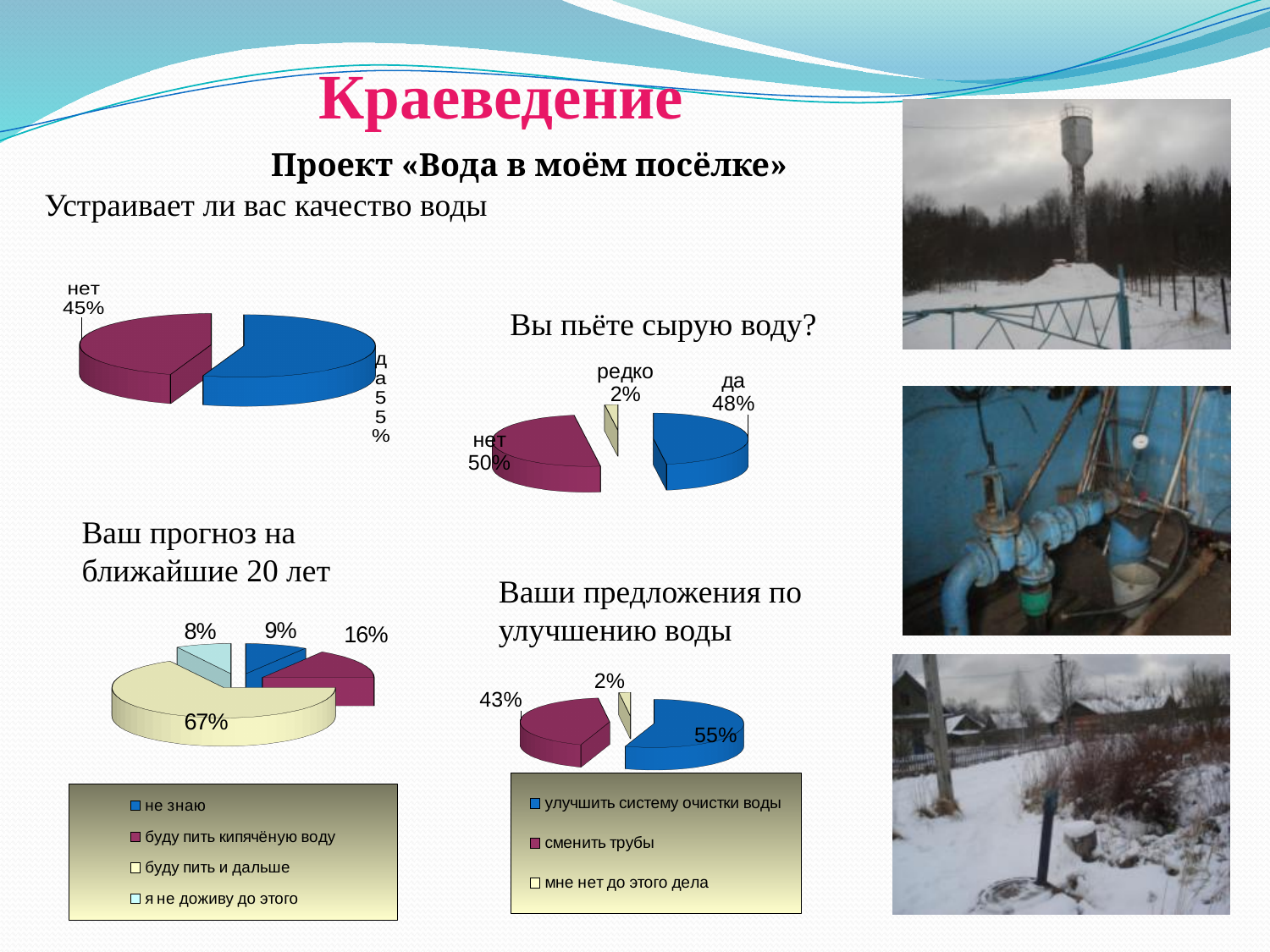
In the chart 'Вы пьёте сырую воду?', what is the value for 'редко'? 2% In the chart 'Вы пьёте сырую воду?', what is the difference between the 'нет' and 'да' shares? 2% In the chart 'Устраивает ли вас качество воды', what share of respondents answered 'нет'? 45% In the chart 'Вы пьёте сырую воду?', how many slices does the pie have? 3 In the chart 'Вы пьёте сырую воду?', which answer has the largest share? нет In the chart 'Ваш прогноз на ближайшие 20 лет', how many entries does the legend list? 4 In the chart 'Устраивает ли вас качество воды', what share of respondents answered 'да'? 55% In the chart 'Ваши предложения по улучшению воды', which proposal has the smallest share? мне нет до этого дела In the chart 'Ваш прогноз на ближайшие 20 лет', what is the share for 'буду пить кипячёную воду'? 16% What type of chart is used for 'Ваши предложения по улучшению воды'? Pie chart In the chart 'Ваши предложения по улучшению воды', what is the share for 'сменить трубы'? 43% In the chart 'Ваш прогноз на ближайшие 20 лет', what is the share for 'буду пить и дальше'? 67%